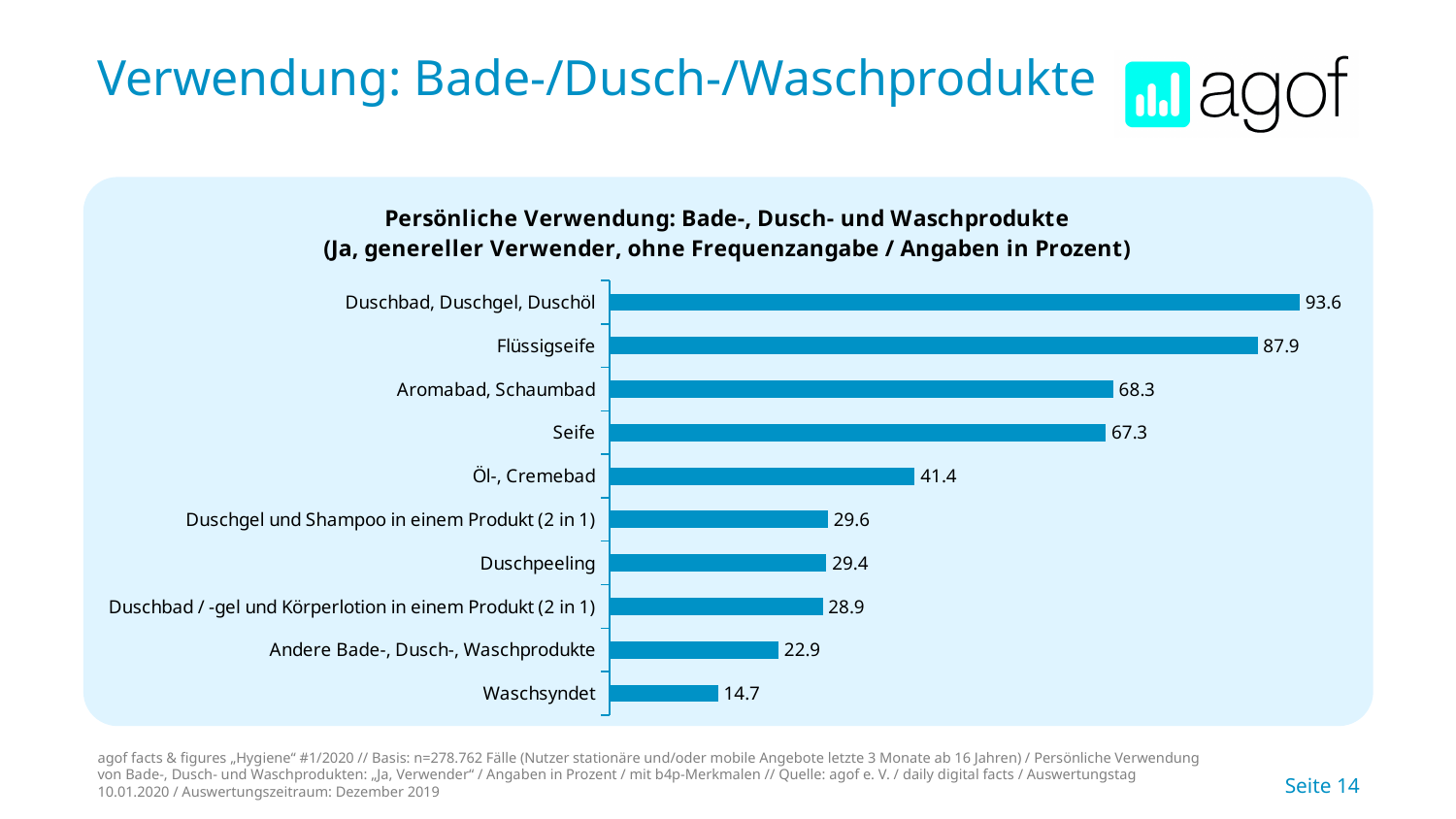
Which is larger: the value for Duschpeeling or the value for Andere Bade-, Dusch-, Waschprodukte? Duschpeeling What is the value for Flüssigseife? 87.9 Which category has the highest value? Duschbad, Duschgel, Duschöl What kind of chart is shown on the slide? Bar chart What is the value for Waschsyndet? 14.7 Which category has the lowest value? Waschsyndet What is the value for Öl-, Cremebad? 41.4 How many categories are shown in the chart? 10 What is the value for Duschgel und Shampoo in einem Produkt (2 in 1)? 29.6 What is the difference between the values for Aromabad, Schaumbad and Seife? 1.0 What is the difference between the values for Duschbad, Duschgel, Duschöl and Flüssigseife? 5.7 What is the title of the chart? Persönliche Verwendung: Bade-, Dusch- und Waschprodukte (Ja, genereller Verwender, ohne Frequenzangabe / Angaben in Prozent)